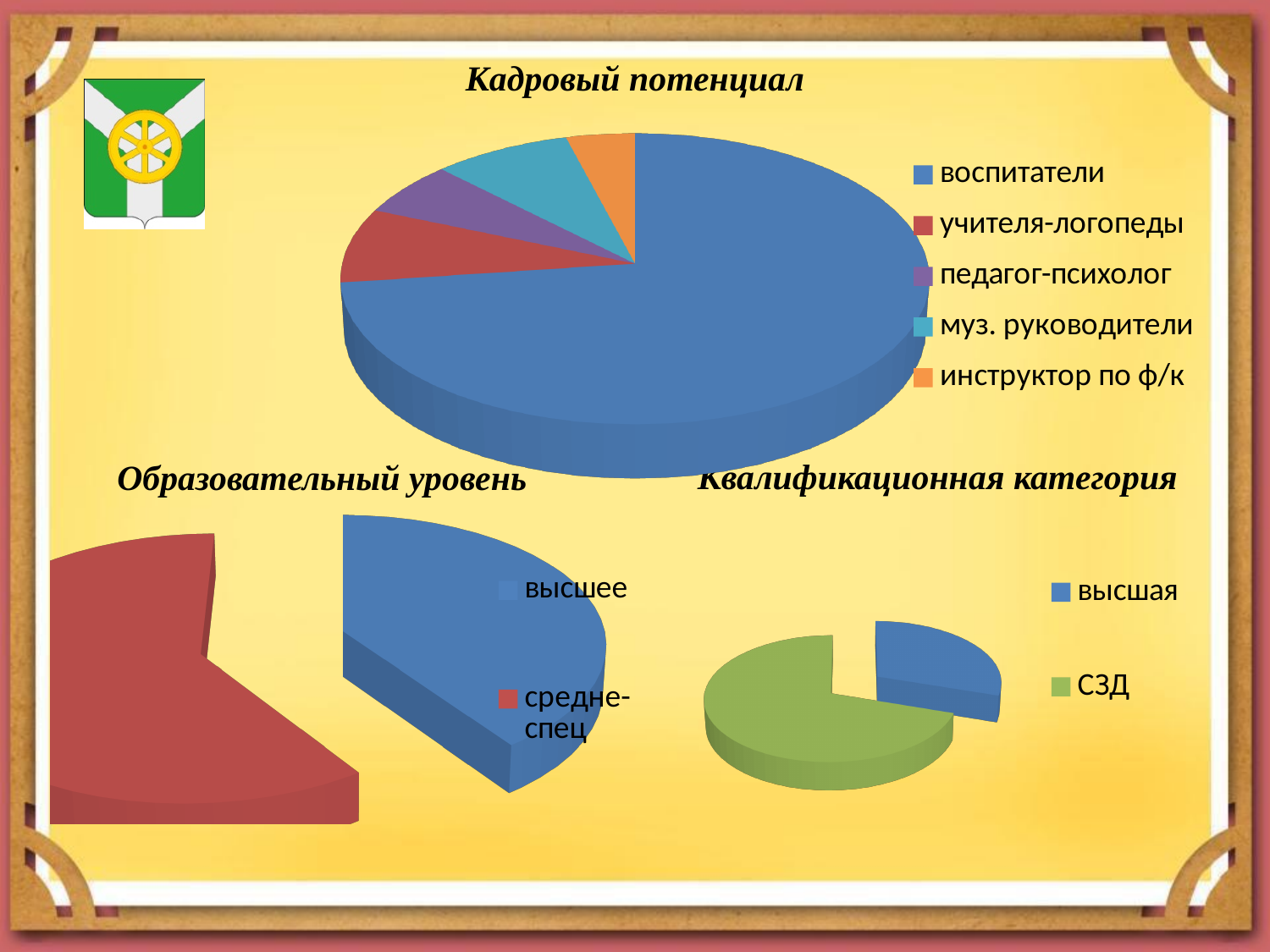
In the "Квалификационная категория" chart, which category has the smallest slice? высшая In the "Кадровый потенциал" chart, how many categories does the legend list? 5 In the "Образовательный уровень" chart, how many categories are shown? 2 What kind of chart is the "Квалификационная категория" chart? pie chart In the "Кадровый потенциал" chart, which colour represents муз. руководители? teal In the "Кадровый потенциал" chart, which slice is larger: воспитатели or учителя-логопеды? воспитатели In the "Кадровый потенциал" chart, which category has the largest slice? воспитатели What kind of chart is the "Образовательный уровень" chart? pie chart In the "Квалификационная категория" chart, how many categories does the legend list? 2 What kind of chart is the "Кадровый потенциал" chart? pie chart In the "Квалификационная категория" chart, which category has the largest slice? СЗД In the "Образовательный уровень" chart, which slice is larger: высшее or средне-спец? средне-спец